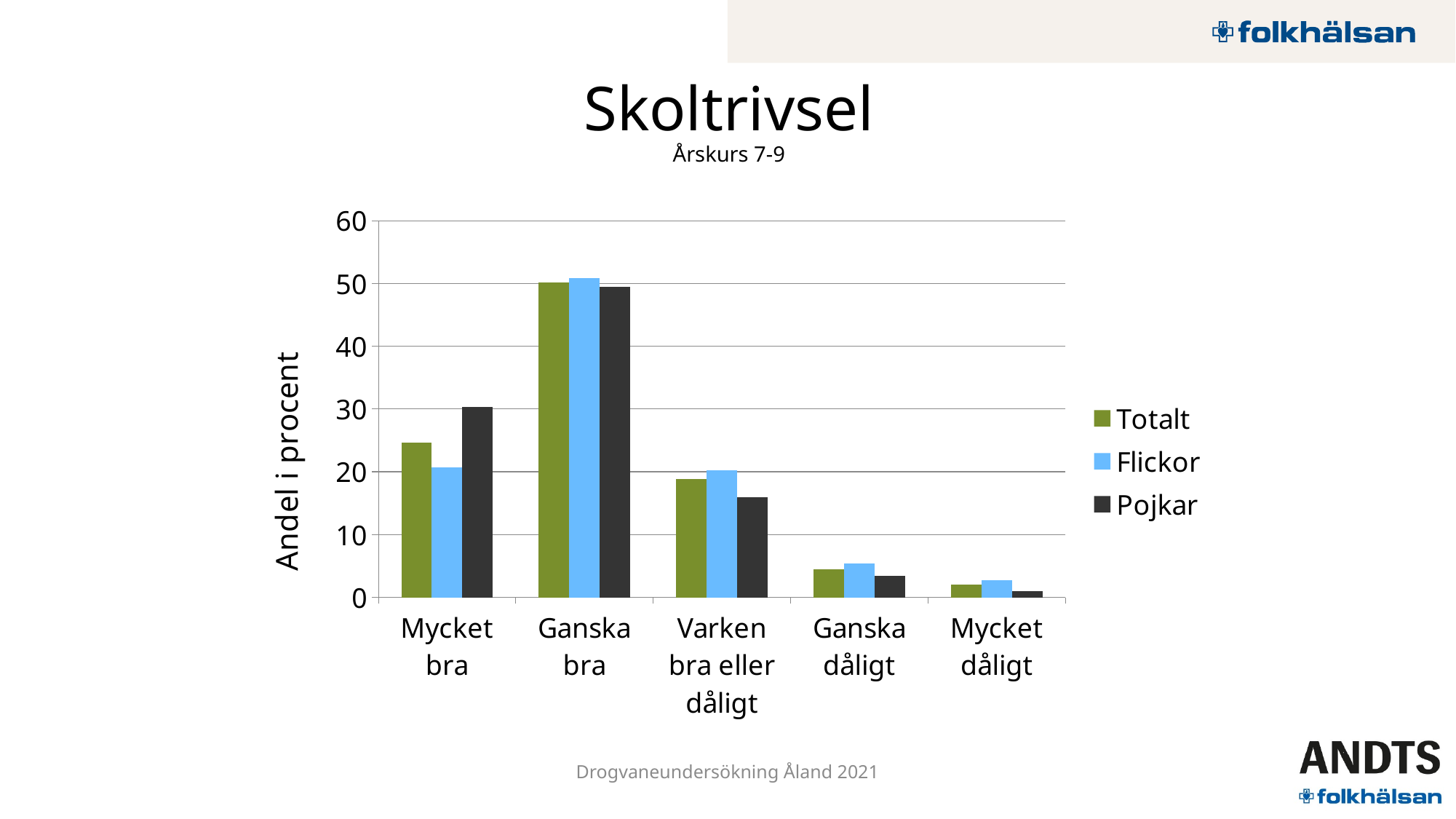
What is the title of the y axis? Andel i procent In the Mycket bra category, which series has the highest bar? Pojkar How many categories are shown on the x axis of the chart? 5 In the Mycket bra category, which is larger: Flickor or Pojkar? Pojkar Is the value for Pojkar in Varken bra eller dåligt greater or less than 20? less What kind of chart is shown on the slide? bar chart Which category has the lowest value for Pojkar? Mycket dåligt Is the value for Totalt in Mycket bra greater or less than 20? greater Which category has the highest value for Totalt? Ganska bra How many series does the legend list? 3 In the Varken bra eller dåligt category, which is larger: Flickor or Pojkar? Flickor Do the Totalt values rise or fall from Ganska bra to Mycket dåligt along the x axis? fall